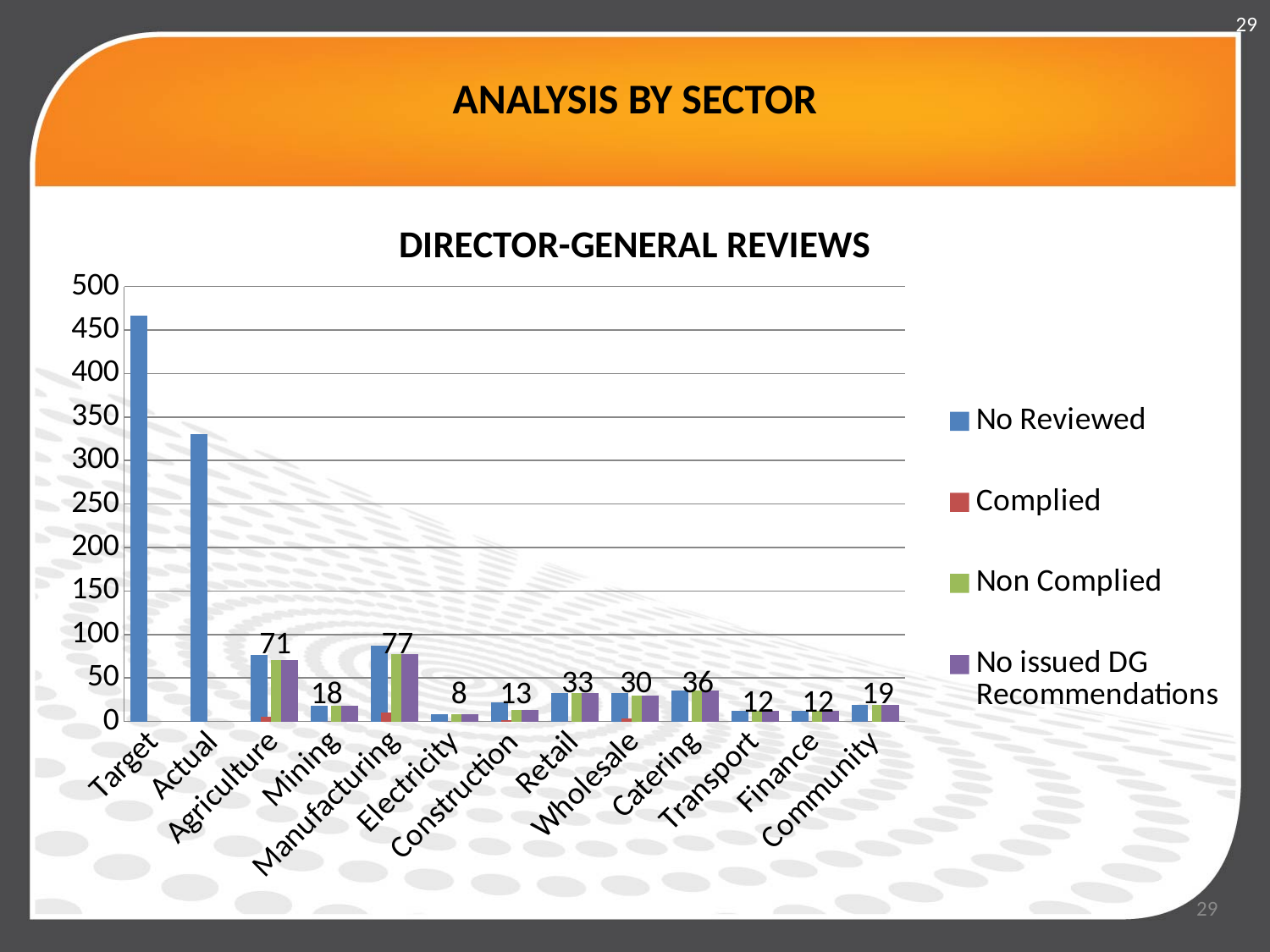
How many categories are shown on the x axis? 13 What value is labelled for Manufacturing? 77 Which sector has the lowest labelled value? Electricity Is the value of the Target bar greater or less than 400? greater What kind of chart is shown on the slide? bar chart What value is labelled for Agriculture? 71 What is the difference between the labelled values for Manufacturing and Agriculture? 6 Which category has the tallest bar in the chart? Target Which has the larger labelled value, Retail or Wholesale? Retail What value is labelled for Electricity? 8 How many series does the legend list? 4 What is the title of the chart? DIRECTOR-GENERAL REVIEWS